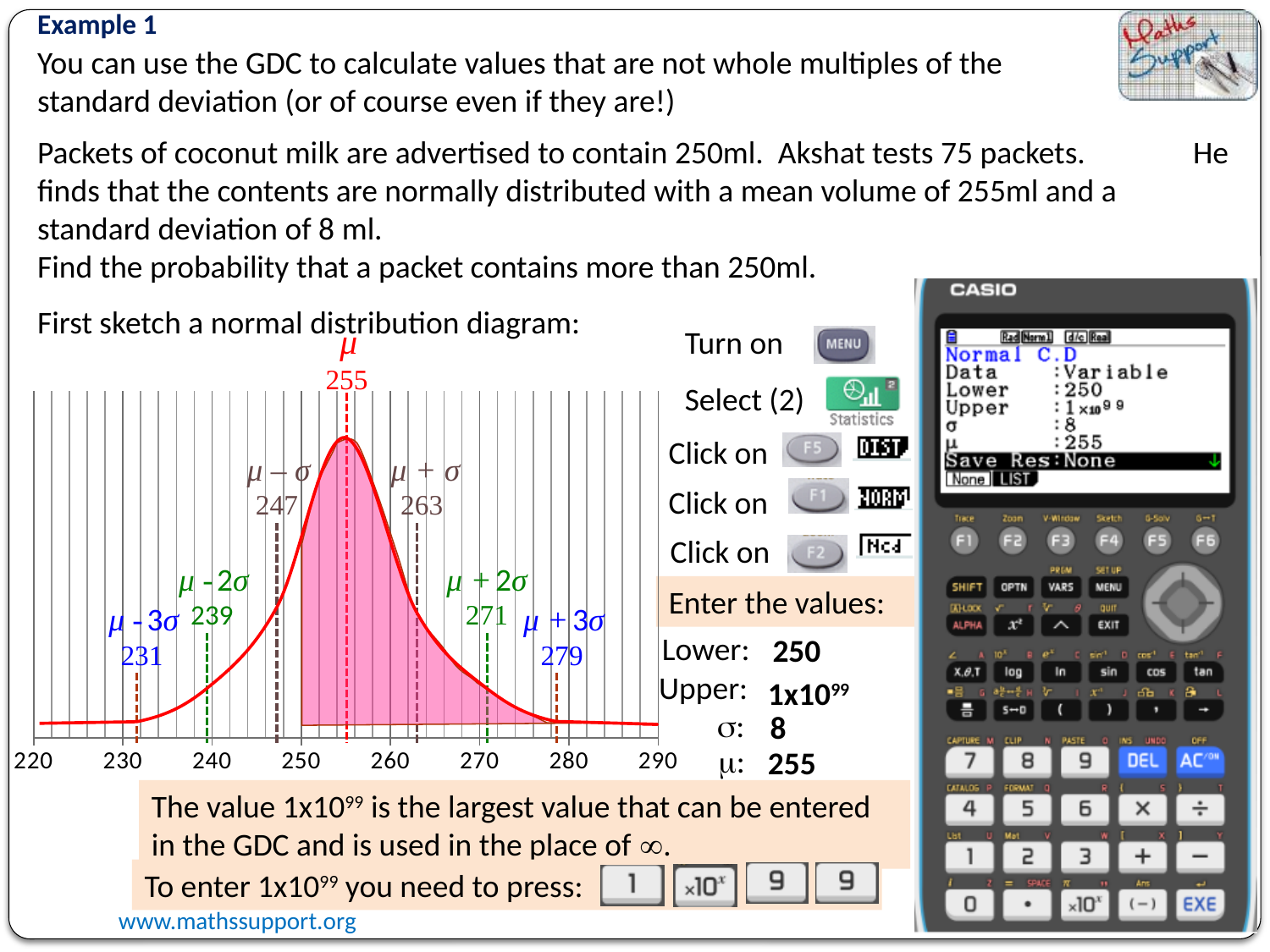
What is the lowest value shown on the x axis of the normal distribution diagram? 220 On the normal distribution diagram, what value is labelled at μ + 3σ? 279 On the normal distribution diagram, what value is labelled at μ − σ? 247 On the normal distribution diagram, what is the difference between the values labelled at μ + 3σ and μ? 24 On the normal distribution diagram, what value is labelled at μ − 3σ? 231 On the normal distribution diagram, what is the difference between the values labelled at μ + σ and μ − σ? 16 On the normal distribution diagram, at what x value does the shaded region begin? 250 On the normal distribution diagram, what value is labelled at μ? 255 On the normal distribution diagram, what value is labelled at μ + σ? 263 What is the highest value shown on the x axis of the normal distribution diagram? 290 On the normal distribution diagram, what value is labelled at μ − 2σ? 239 On the normal distribution diagram, what value is labelled at μ + 2σ? 271